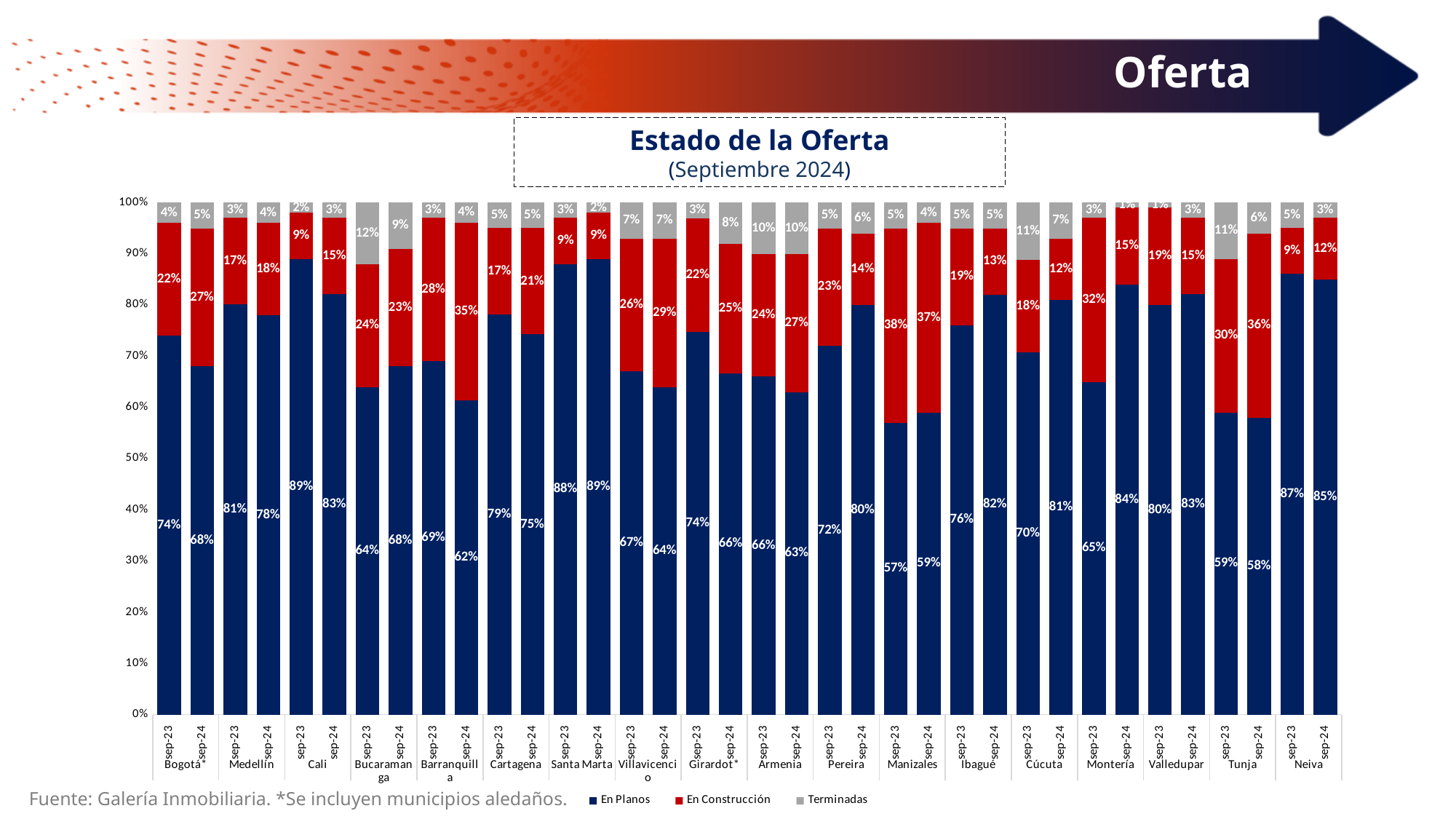
How many series does the legend list? 3 What is the Terminadas share for Bucaramanga in sep-23? 12% What kind of chart is shown on the slide? Stacked bar chart Which city has the lowest En Planos share in sep-24? Tunja Which city has the highest En Planos share in sep-24? Santa Marta Which is larger: the En Construcción share for Barranquilla in sep-24 or for Tunja in sep-24? Tunja in sep-24 (36%) Did the En Planos share for Cúcuta rise or fall from sep-23 to sep-24? Rise What is the En Planos share for Bogotá* in sep-24? 68% By how many percentage points did the En Planos share for Montería change from sep-23 to sep-24? 19 percentage points What is the title of the chart? Estado de la Oferta (Septiembre 2024) What is the En Construcción share for Manizales in sep-23? 38% How many cities are shown on the x axis of the chart? 18